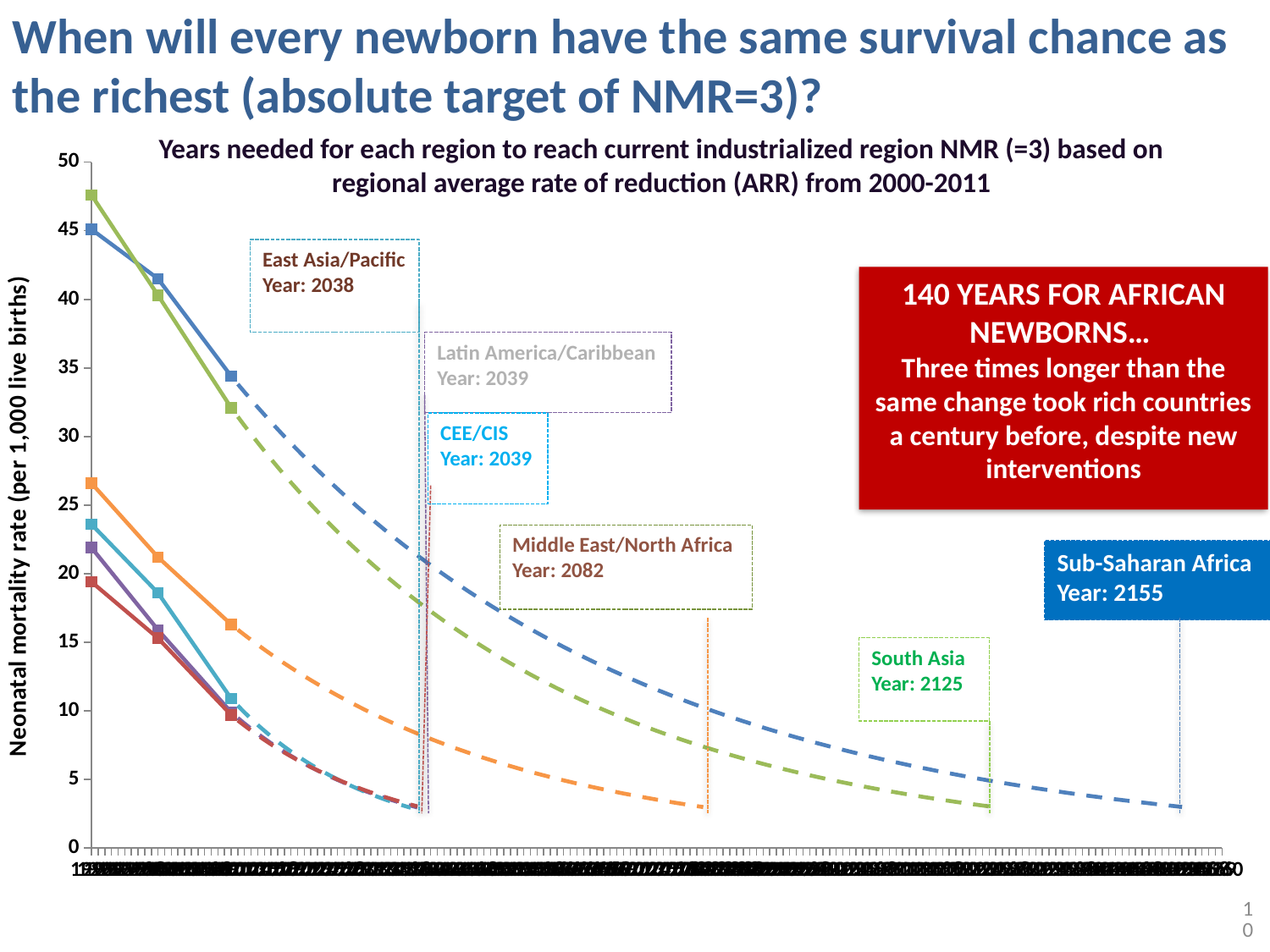
According to the chart annotation, in what year is Sub-Saharan Africa projected to reach an NMR of 3? 2155 How many years later is Sub-Saharan Africa's annotated target year than East Asia/Pacific's? 117 According to the chart annotation, in what year is Middle East/North Africa projected to reach an NMR of 3? 2082 What is the label of the y-axis of the chart? Neonatal mortality rate (per 1,000 live births) Which region is annotated with a later target year, South Asia or Middle East/North Africa? South Asia What kind of chart is shown on the slide? line chart According to the chart annotation, in what year is South Asia projected to reach an NMR of 3? 2125 According to the chart annotation, in what year is East Asia/Pacific projected to reach an NMR of 3? 2038 Which region is annotated with the earliest year for reaching an NMR of 3? East Asia/Pacific How many regions are annotated with a target year on the chart? 6 How many years later is South Asia's annotated target year than Middle East/North Africa's? 43 Which region is annotated with the latest year for reaching an NMR of 3? Sub-Saharan Africa